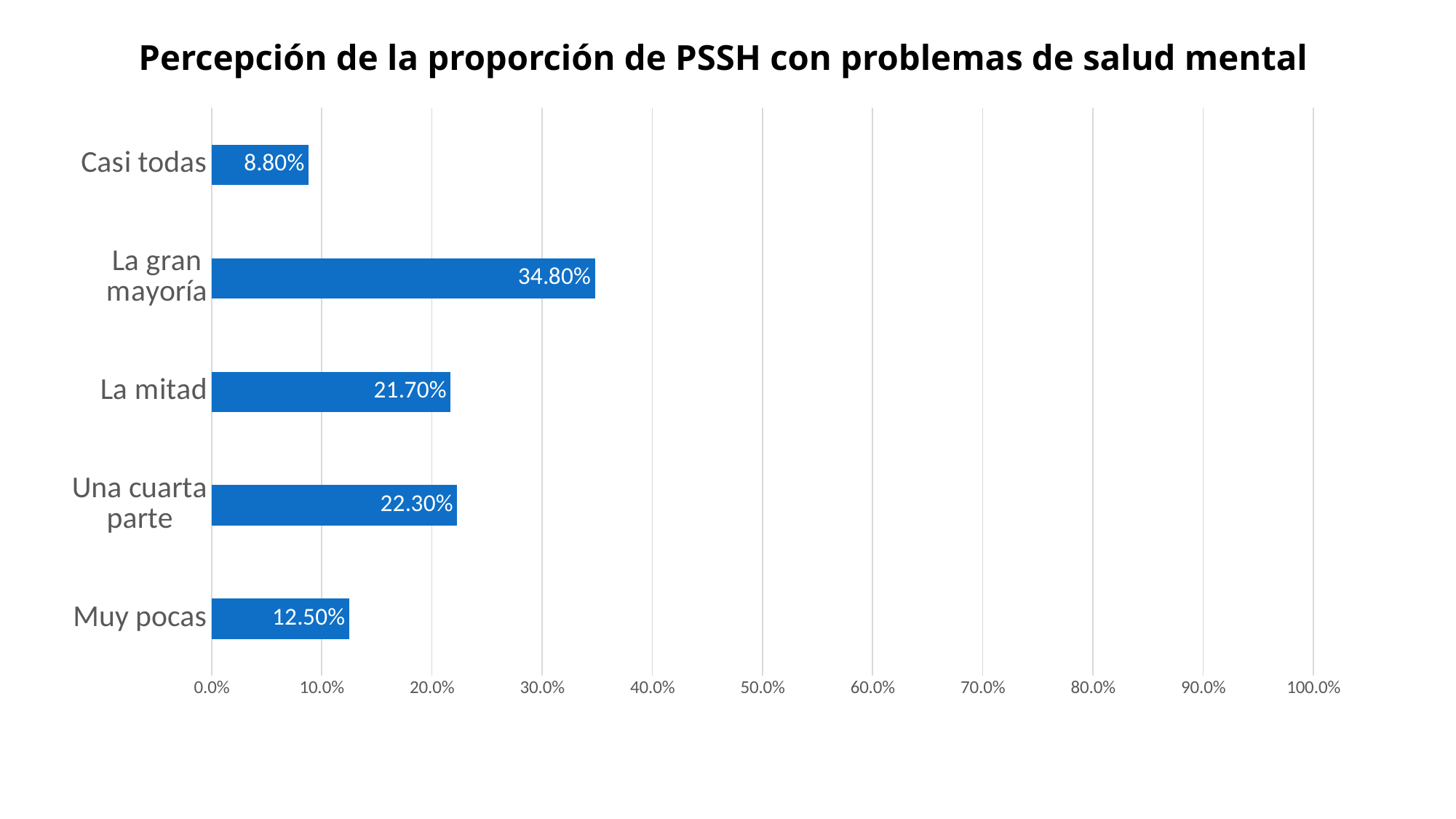
What is the value for 'Muy pocas'? 12.50% Which category has the highest value? La gran mayoría What is the value for 'La gran mayoría'? 34.80% What is the difference between the values for 'Muy pocas' and 'Casi todas'? 3.70% What is the difference between the values for 'La gran mayoría' and 'La mitad'? 13.10% What is the title of the chart? Percepción de la proporción de PSSH con problemas de salud mental Which category has the lowest value? Casi todas What is the value for 'Casi todas'? 8.80% Which is larger, the value for 'Una cuarta parte' or the value for 'Muy pocas'? Una cuarta parte What kind of chart is shown on the slide? bar chart How many categories are shown in the chart? 5 Is the value for 'La gran mayoría' greater or less than 30.0%? greater